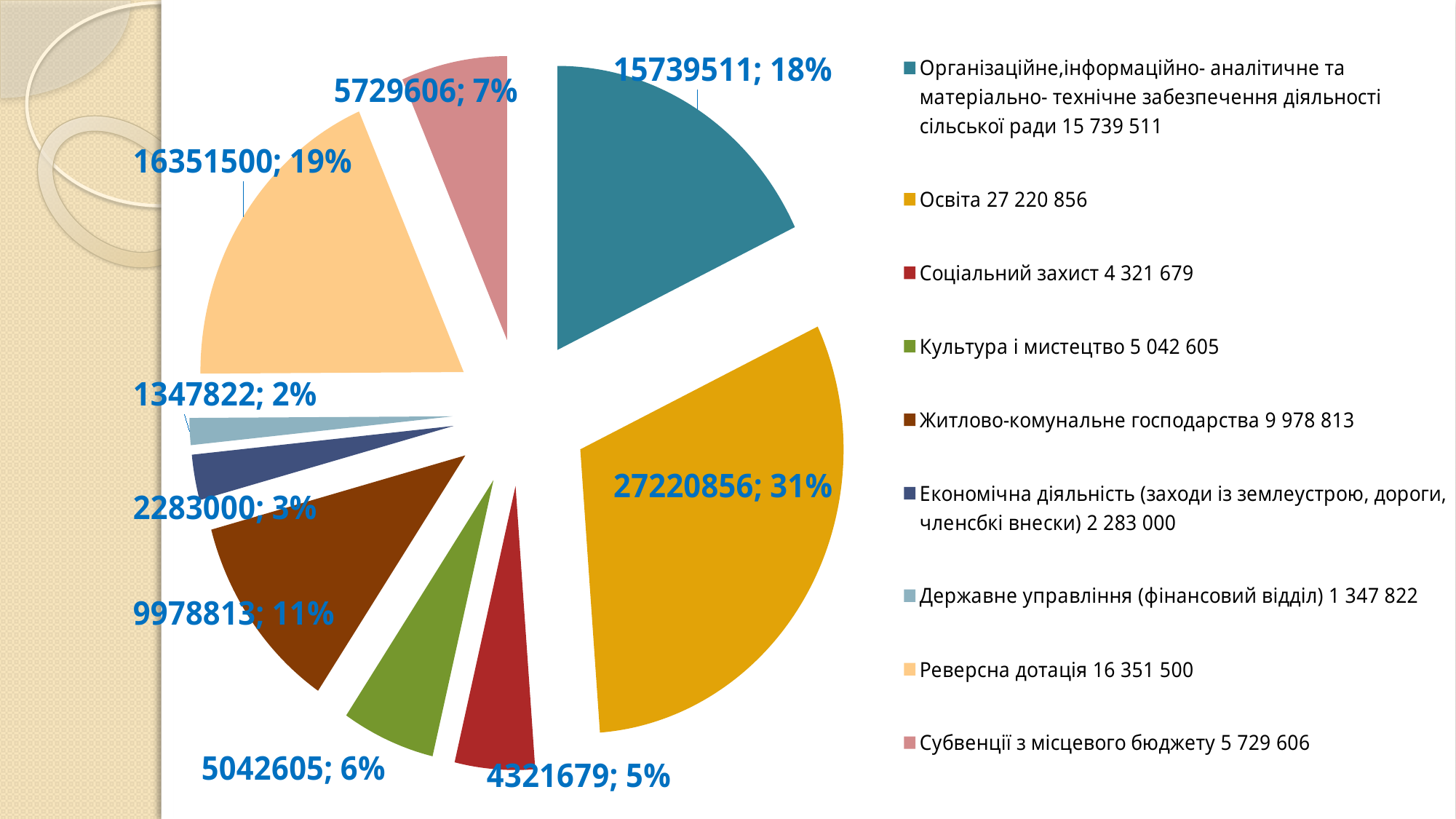
What percentage share does Соціальний захист have in the pie chart? 5% Which category has the smallest slice of the pie? Державне управління (фінансовий відділ) Which is larger, the value for Житлово-комунальне господарства or for Субвенції з місцевого бюджету? Житлово-комунальне господарства What is the value shown for Освіта? 27220856 What kind of chart is shown on the slide? pie chart What is the difference between the values for Культура і мистецтво and Соціальний захист? 720926 What is the value shown for Житлово-комунальне господарства? 9978813 What colour is the slice for Економічна діяльність? dark blue Which category has the largest slice of the pie? Освіта What is the difference between the values for Освіта and Реверсна дотація? 10869356 How many slices does the pie chart have? 9 What percentage share does Реверсна дотація have in the pie chart? 19%